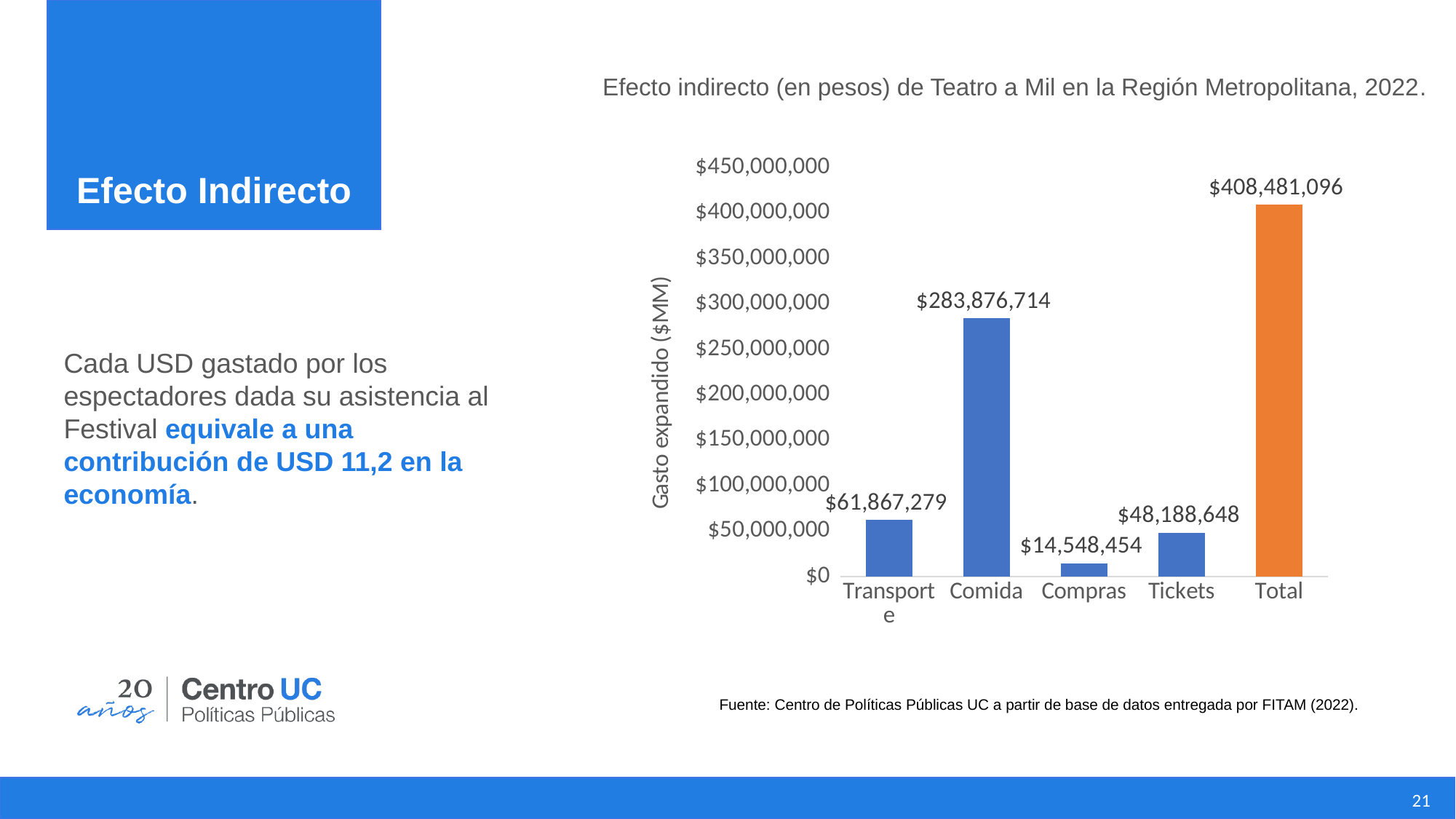
Which is larger, the value for Transporte or the value for Tickets? Transporte How many bars are shown in the chart? 5 What is the difference between the values for Transporte and Tickets? $13,678,631 What is the value of the Total bar? $408,481,096 Which category has the lowest value? Compras What is the value for Tickets? $48,188,648 What kind of chart is shown on the slide? Bar chart What is the value for Transporte? $61,867,279 What is the value for Comida? $283,876,714 Excluding the Total bar, which category has the highest value? Comida What is the label of the vertical axis? Gasto expandido ($MM) What is the value for Compras? $14,548,454